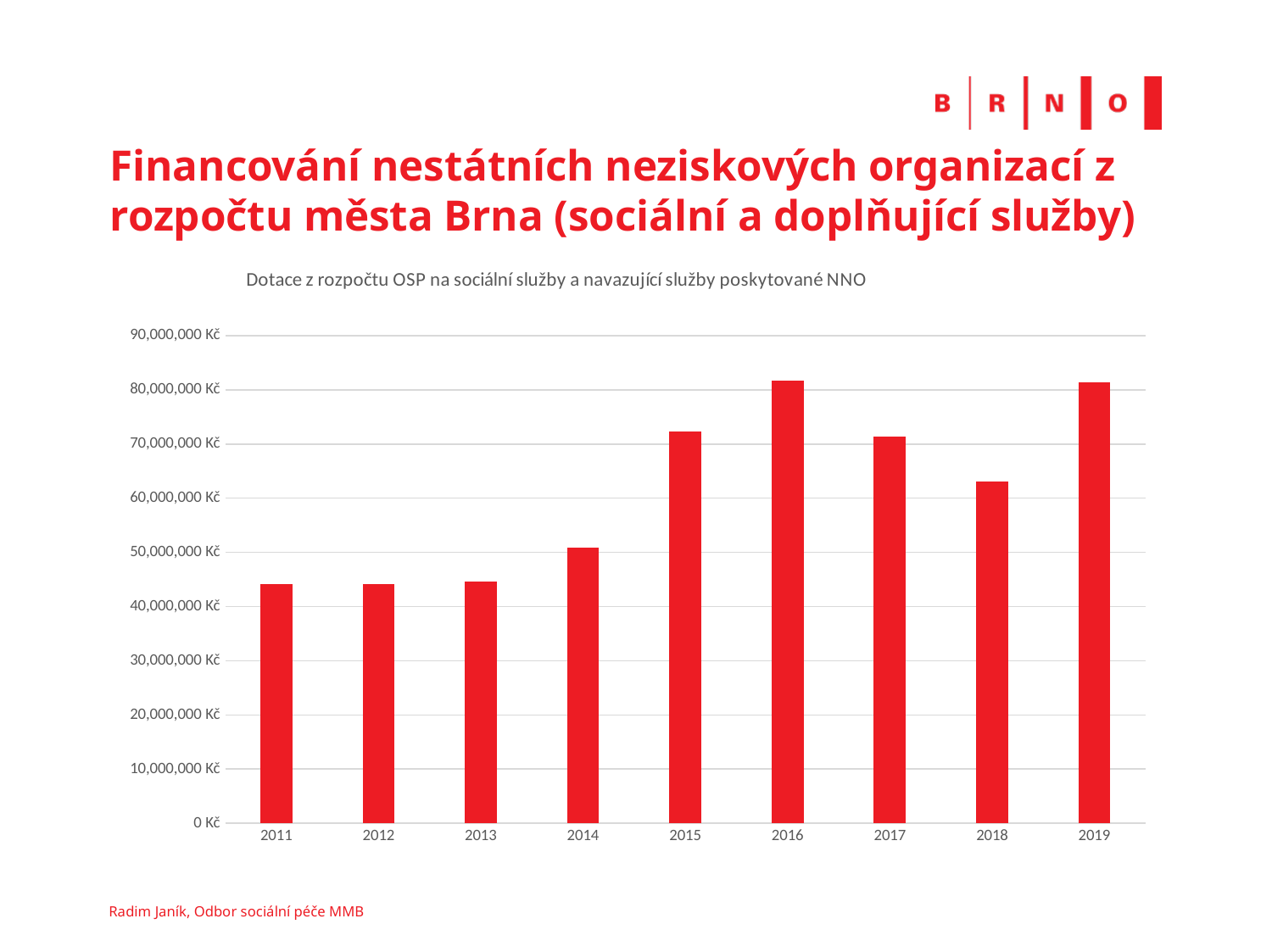
Is the value for 2015 greater or less than 70,000,000 Kč? greater Do the values rise or fall from 2011 to 2016? rise Which year has the larger value, 2013 or 2014? 2014 Which year has the larger value, 2016 or 2018? 2016 What kind of chart is shown on the slide? bar chart Is the value for 2014 greater or less than 60,000,000 Kč? less What is the title of the chart? Dotace z rozpočtu OSP na sociální služby a navazující služby poskytované NNO Is the value for 2017 greater or less than 80,000,000 Kč? less How many years are shown on the x axis of the chart? 9